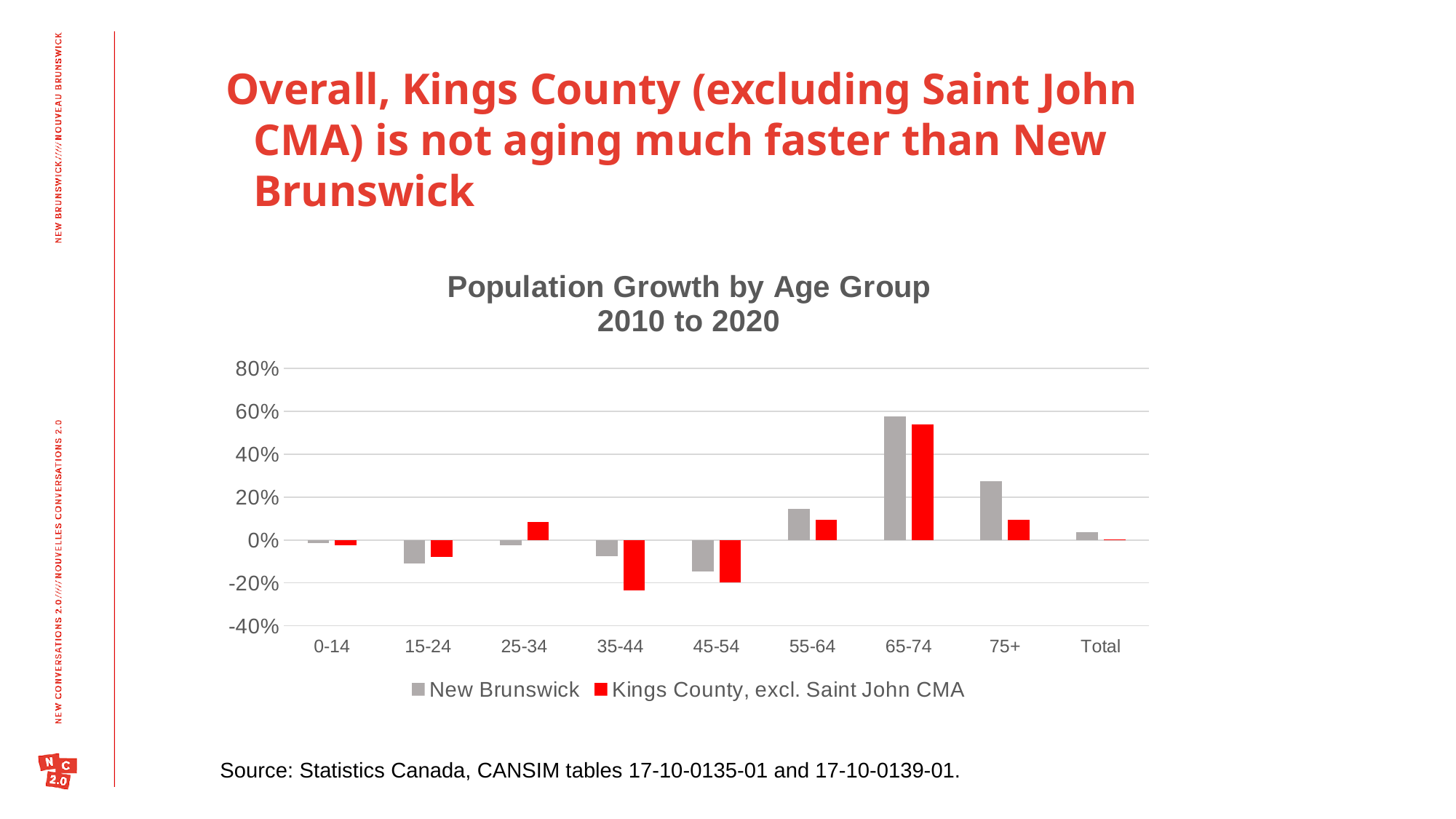
What kind of chart is shown on the slide? bar chart For the 75+ age group, which series has the larger value: New Brunswick or Kings County, excl. Saint John CMA? New Brunswick How many series does the legend list? 2 For the 25-34 age group, which series has the larger value: New Brunswick or Kings County, excl. Saint John CMA? Kings County, excl. Saint John CMA Which age group has the highest population growth for Kings County, excl. Saint John CMA? 65-74 Which age group has the highest population growth for New Brunswick? 65-74 Which age group has the lowest population growth for New Brunswick? 45-54 Which age group has the lowest population growth for Kings County, excl. Saint John CMA? 35-44 How many age-group categories are shown on the x axis, including Total? 9 Is the value for Kings County, excl. Saint John CMA in the 35-44 age group greater or less than -10%? less Is the value for New Brunswick in the 65-74 age group greater or less than 40%? greater What is the title of the chart? Population Growth by Age Group 2010 to 2020